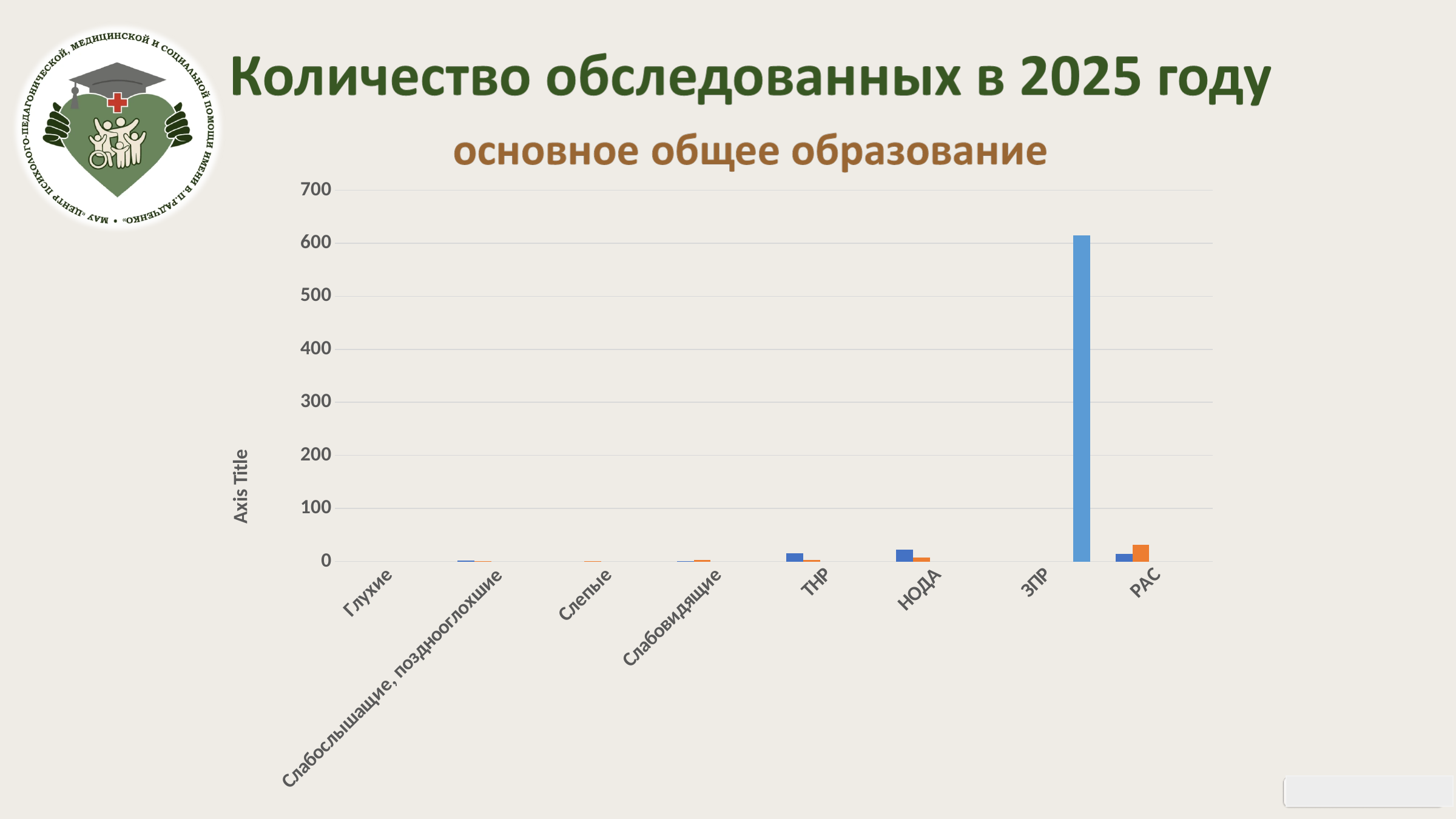
What kind of chart is shown on the slide? bar chart What text is shown as the vertical axis title of the chart? Axis Title Which is larger: the orange bar for РАС or the orange bar for НОДА? РАС Is the value of the tallest bar for ЗПР greater or less than 500? greater What is the highest value shown on the vertical axis of the chart? 700 Which category has the highest bar in the chart? ЗПР Is the value of the orange bar for РАС greater or less than 100? less Which is larger: the blue bar for ТНР or the blue bar for ЗПР? ЗПР How many categories are shown on the x axis of the chart? 8 Which is larger: the blue bar for ЗПР or the blue bar for РАС? ЗПР Is the value of the blue bar for НОДА greater or less than 100? less